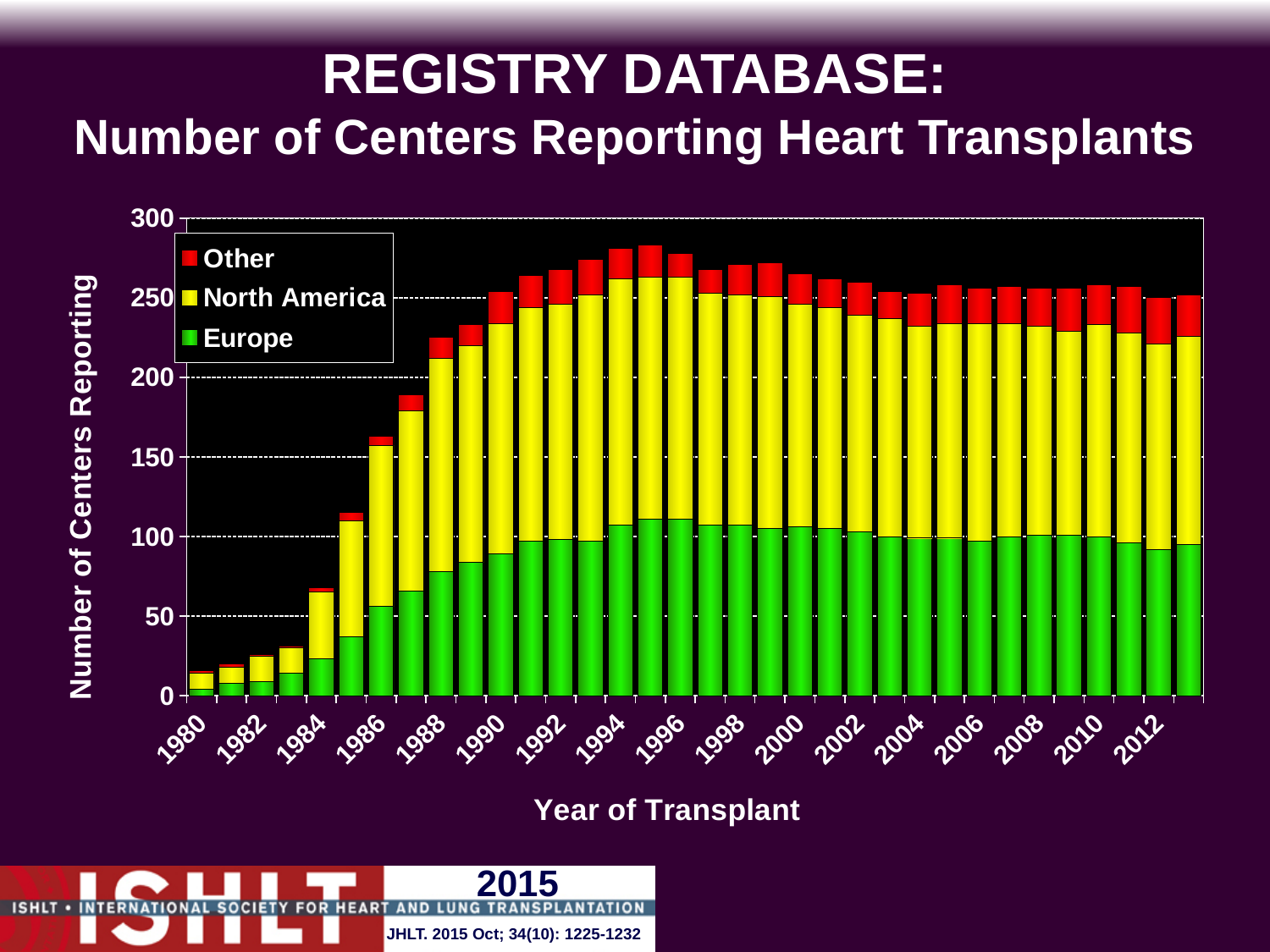
Which year has the lowest total number of centers reporting? 1980 Is the total number of centers reporting in 1986 greater or less than 150? greater Does the total number of centers reporting rise or fall from 1980 to 1995? rise Is the total number of centers reporting in 1980 greater or less than 50? less Which year has the larger total number of centers reporting, 1985 or 1990? 1990 Which series is shown in green? Europe How many series does the legend list? 3 Is the number of European centers reporting in 1996 greater or less than 100? greater What is the title of the y axis? Number of Centers Reporting What kind of chart is shown on the slide? Stacked bar chart